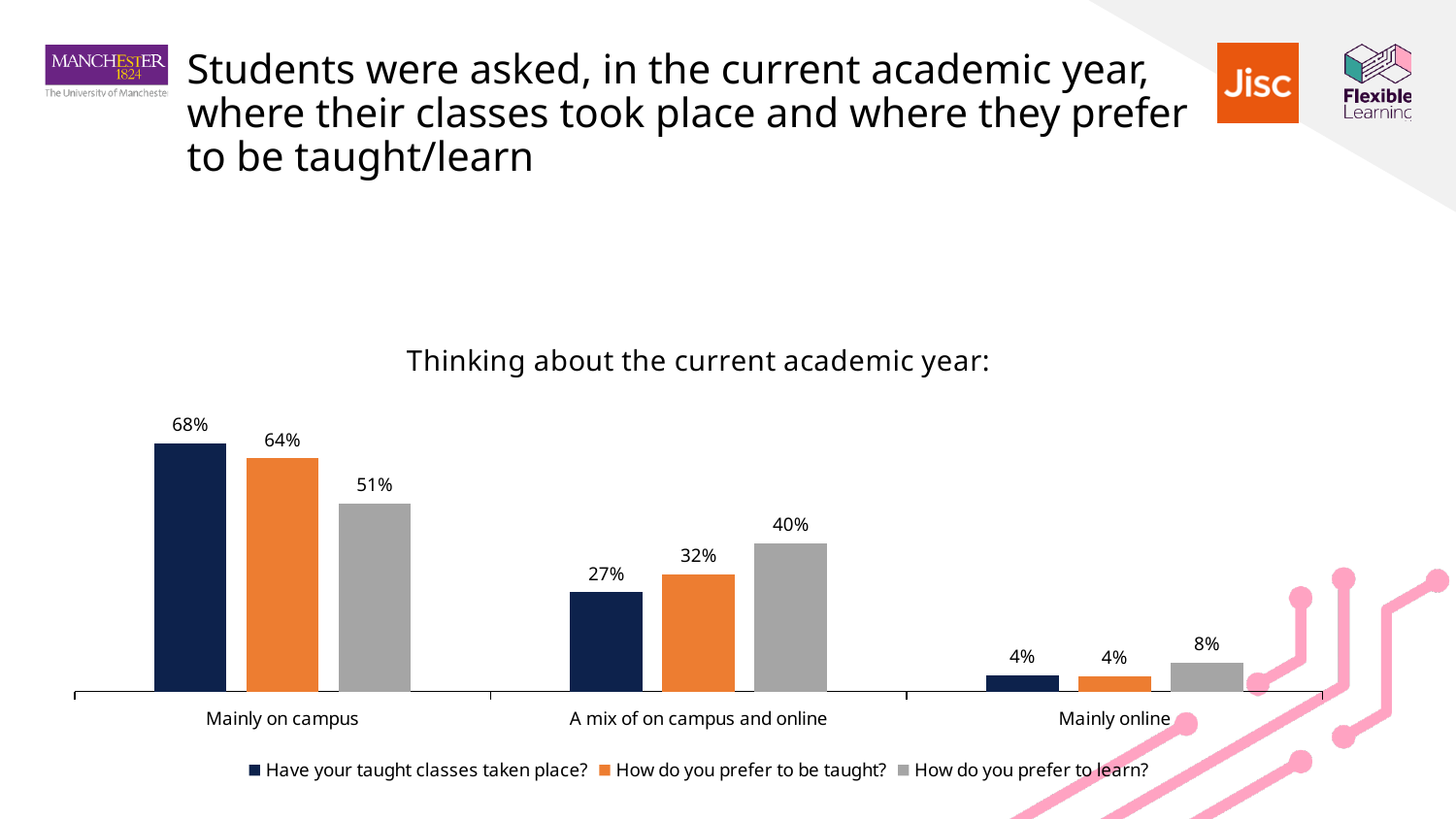
Which category has the lowest value for 'How do you prefer to learn?' Mainly online What percentage of students prefer to be taught mainly online? 4% What is the difference between the 'Have your taught classes taken place?' value and the 'How do you prefer to learn?' value for 'Mainly on campus'? 17% How many categories are shown on the x axis? 3 Do the values for 'Have your taught classes taken place?' rise or fall from 'Mainly on campus' to 'Mainly online'? Fall Which category has the highest value for 'Have your taught classes taken place?' Mainly on campus What percentage of students prefer to learn through a mix of on campus and online? 40% What percentage of students said their taught classes took place mainly on campus? 68% For 'A mix of on campus and online', which is larger: 'How do you prefer to be taught?' or 'How do you prefer to learn?' How do you prefer to learn? What kind of chart is shown on the slide? Bar chart What is the title of the chart? Thinking about the current academic year: How many series does the legend list? 3